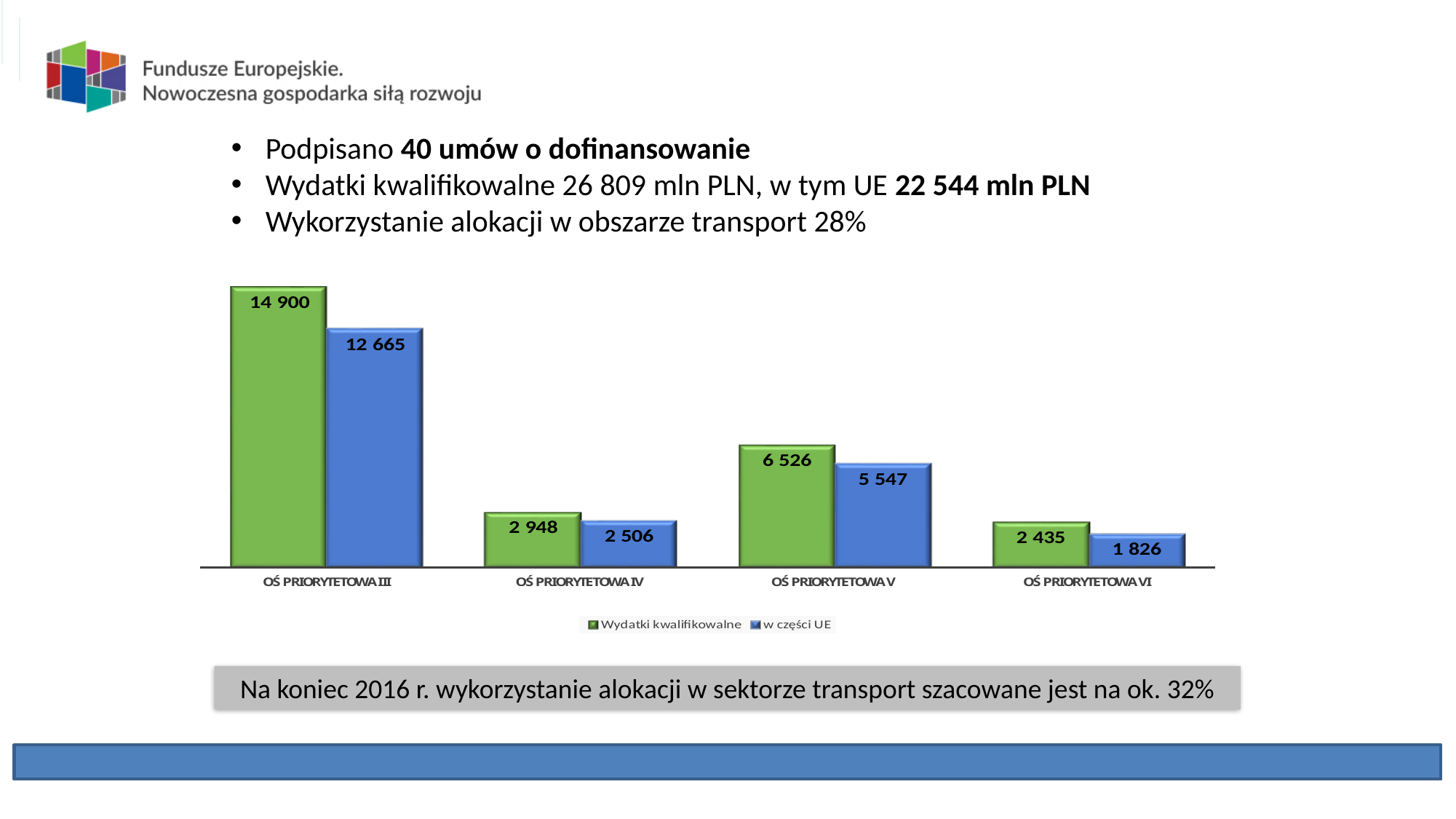
What is the difference between Wydatki kwalifikowalne for OŚ PRIORYTETOWA IV and OŚ PRIORYTETOWA VI? 513 Which is larger: w części UE for OŚ PRIORYTETOWA IV or for OŚ PRIORYTETOWA VI? OŚ PRIORYTETOWA IV How many series does the legend list? 2 How many categories are shown on the x axis of the chart? 4 What is the value of Wydatki kwalifikowalne for OŚ PRIORYTETOWA III? 14 900 Which category has the highest value for Wydatki kwalifikowalne? OŚ PRIORYTETOWA III What is the value of Wydatki kwalifikowalne for OŚ PRIORYTETOWA IV? 2 948 What kind of chart is shown on the slide? Bar chart What is the value of w części UE for OŚ PRIORYTETOWA V? 5 547 What is the value of w części UE for OŚ PRIORYTETOWA VI? 1 826 Which category has the lowest value for w części UE? OŚ PRIORYTETOWA VI What is the difference between Wydatki kwalifikowalne and w części UE for OŚ PRIORYTETOWA III? 2 235